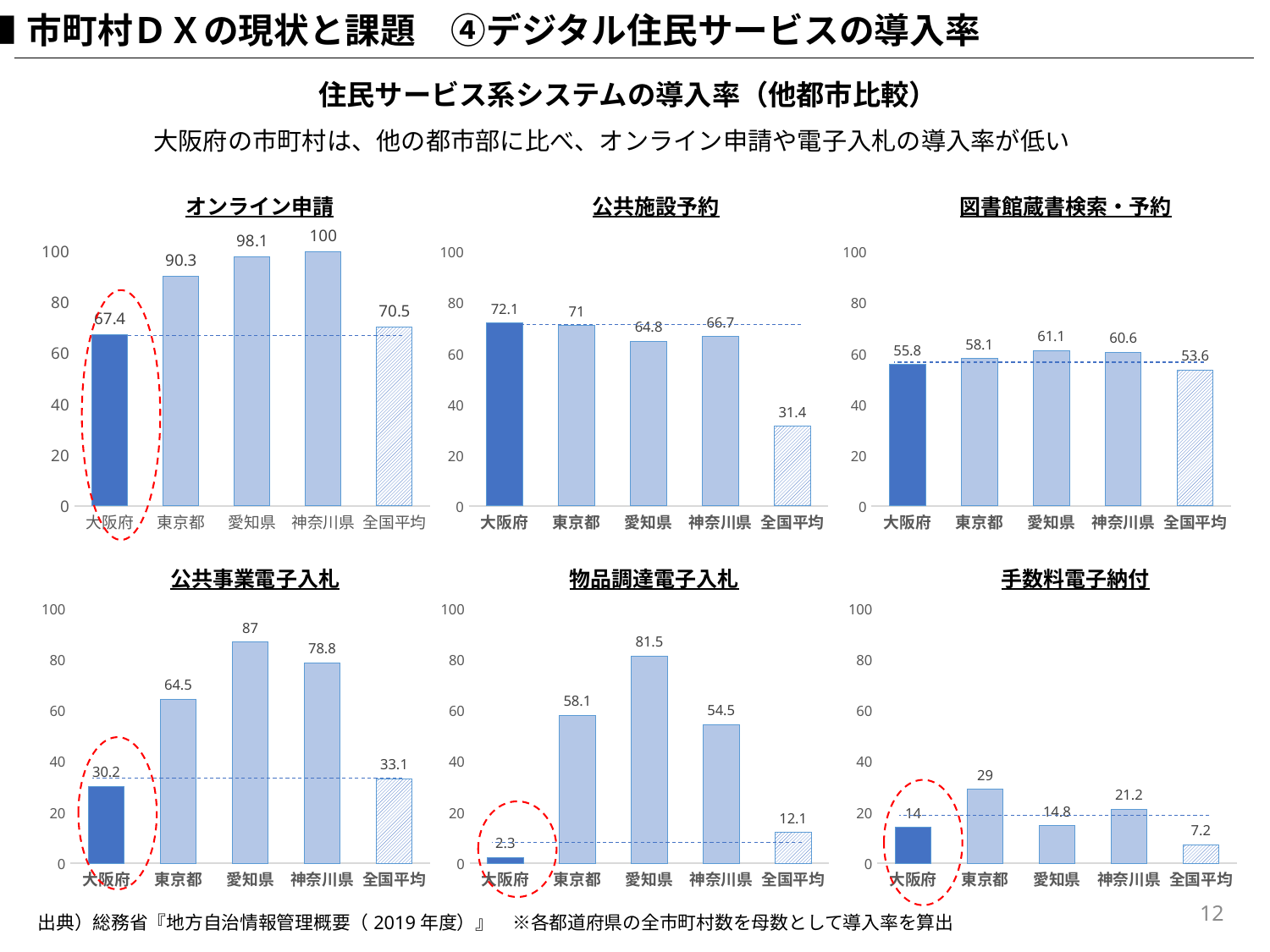
In the 公共施設予約 chart, what is the value for 全国平均? 31.4 In the オンライン申請 chart, which category has the highest value? 神奈川県 In the 物品調達電子入札 chart, what is the value for 大阪府? 2.3 In the オンライン申請 chart, what is the value for 大阪府? 67.4 In the 物品調達電子入札 chart, which category has the highest value? 愛知県 In the 公共事業電子入札 chart, what is the difference between 愛知県 and 大阪府? 56.8 In the 手数料電子納付 chart, what is the value for 東京都? 29 In the 公共施設予約 chart, which category has the lowest value? 全国平均 What type of chart is the オンライン申請 chart? bar chart How many categories are shown in the 手数料電子納付 chart? 5 In the 図書館蔵書検索・予約 chart, what is the value for 愛知県? 61.1 In the 公共事業電子入札 chart, which is larger, 東京都 or 神奈川県? 神奈川県